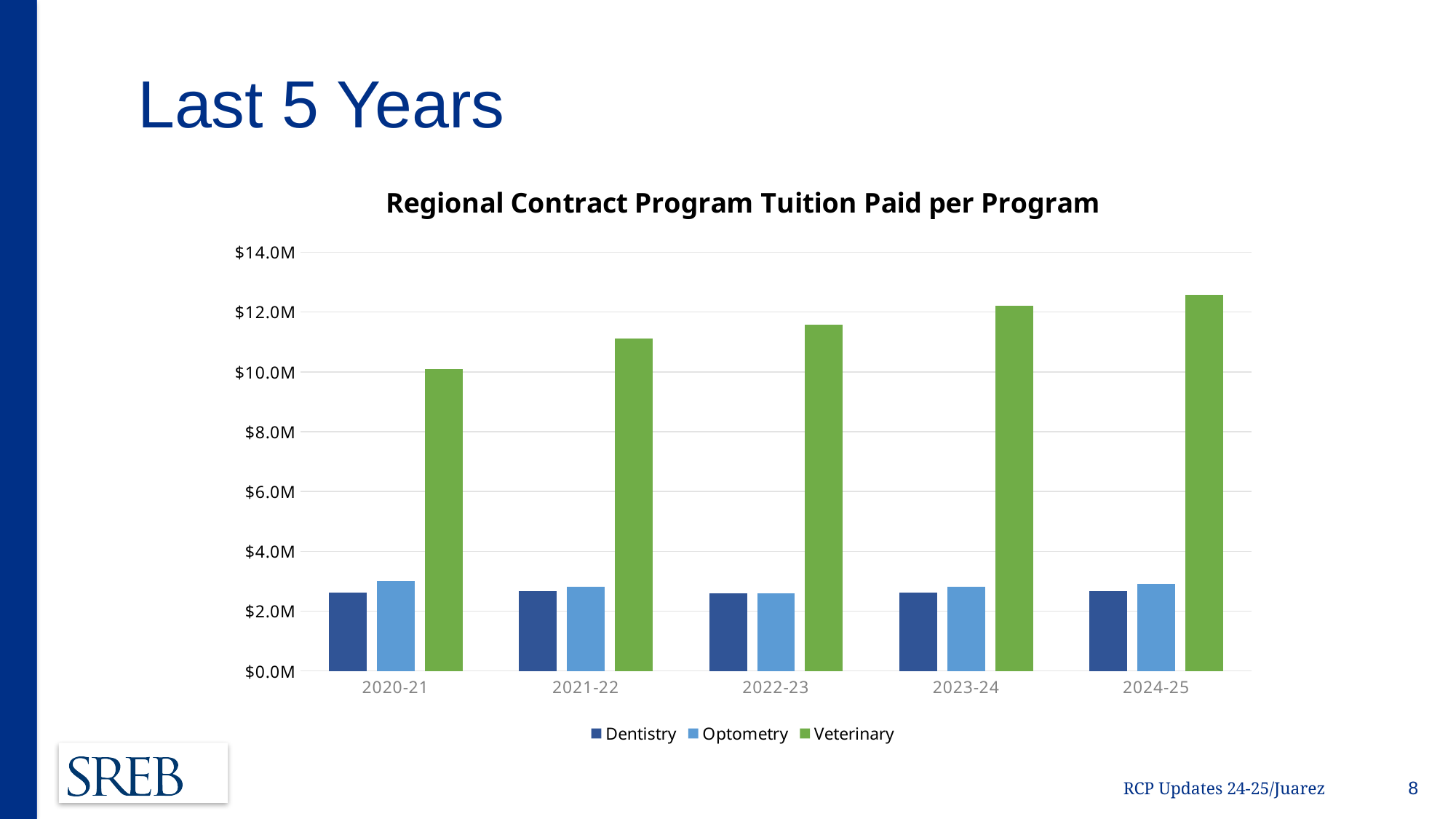
Is the Veterinary value for 2022-23 greater or less than $12.0M? less In which year is the Veterinary value lowest? 2020-21 What is the title of the chart? Regional Contract Program Tuition Paid per Program In which year is the Veterinary value highest? 2024-25 Is the Dentistry value for 2020-21 greater or less than $2.0M? greater Do the Veterinary values rise or fall from 2020-21 to 2024-25? rise In 2021-22, which is larger, the Veterinary value or the Dentistry value? Veterinary Is the Veterinary value for 2024-25 greater or less than $12.0M? greater What type of chart is shown on the slide? bar chart How many series does the legend list? 3 Which series is shown in green? Veterinary How many academic years are shown on the x axis? 5